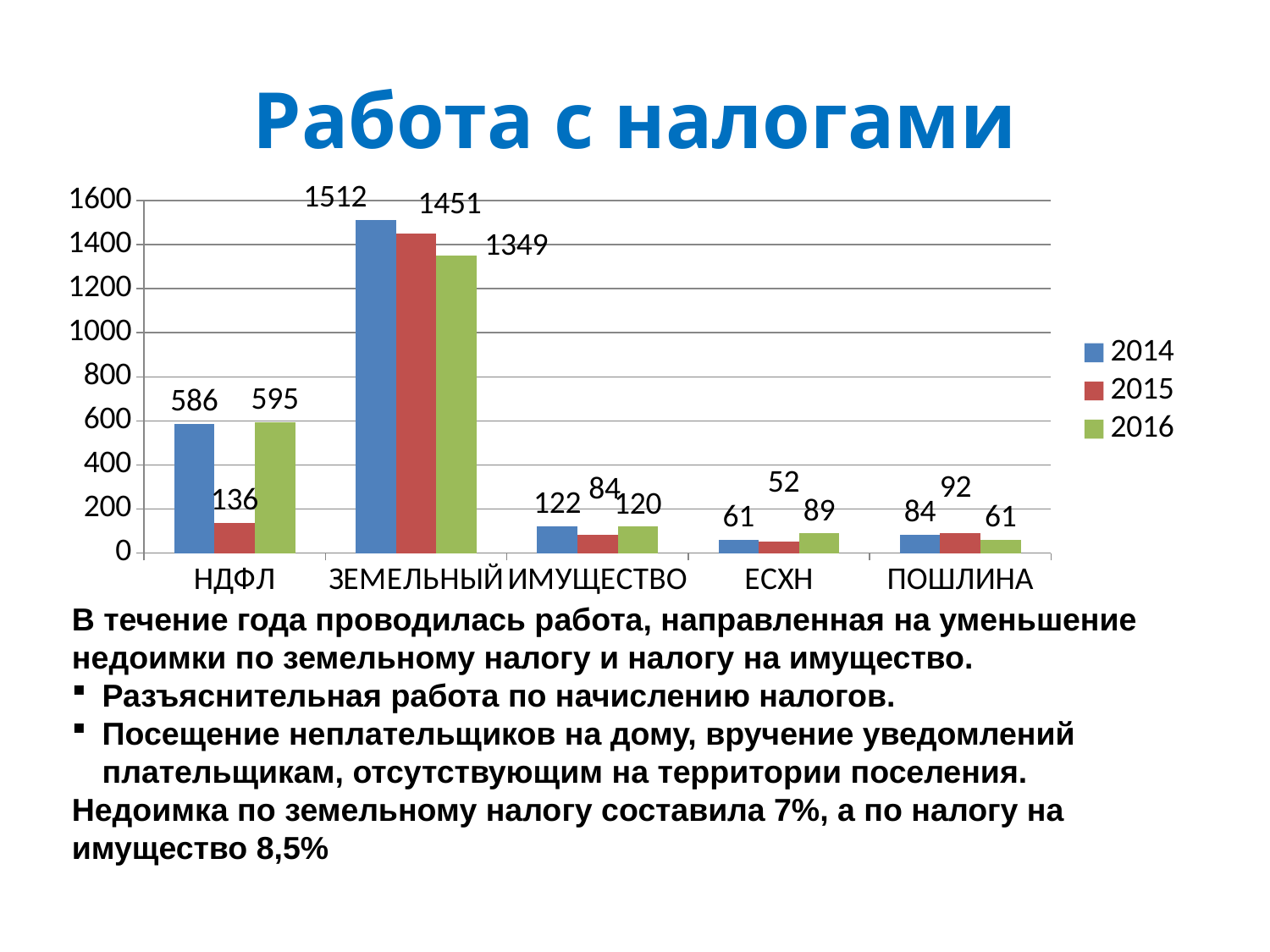
What is the value for НДФЛ in the 2015 series? 136 Which is larger for ИМУЩЕСТВО: the 2014 value or the 2016 value? 2014 What is the value for ПОШЛИНА in the 2015 series? 92 Which category has the lowest value in the 2015 series? ЕСХН How many categories are shown on the x axis? 5 What is the value for ЗЕМЕЛЬНЫЙ in the 2014 series? 1512 What kind of chart is shown on the slide? Bar chart What is the value for ЕСХН in the 2016 series? 89 Do the values for ЗЕМЕЛЬНЫЙ rise or fall from 2014 to 2016? Fall How many series does the legend list? 3 Which category has the highest value in the 2016 series? ЗЕМЕЛЬНЫЙ What is the difference between the 2014 and 2016 values for ЗЕМЕЛЬНЫЙ? 163